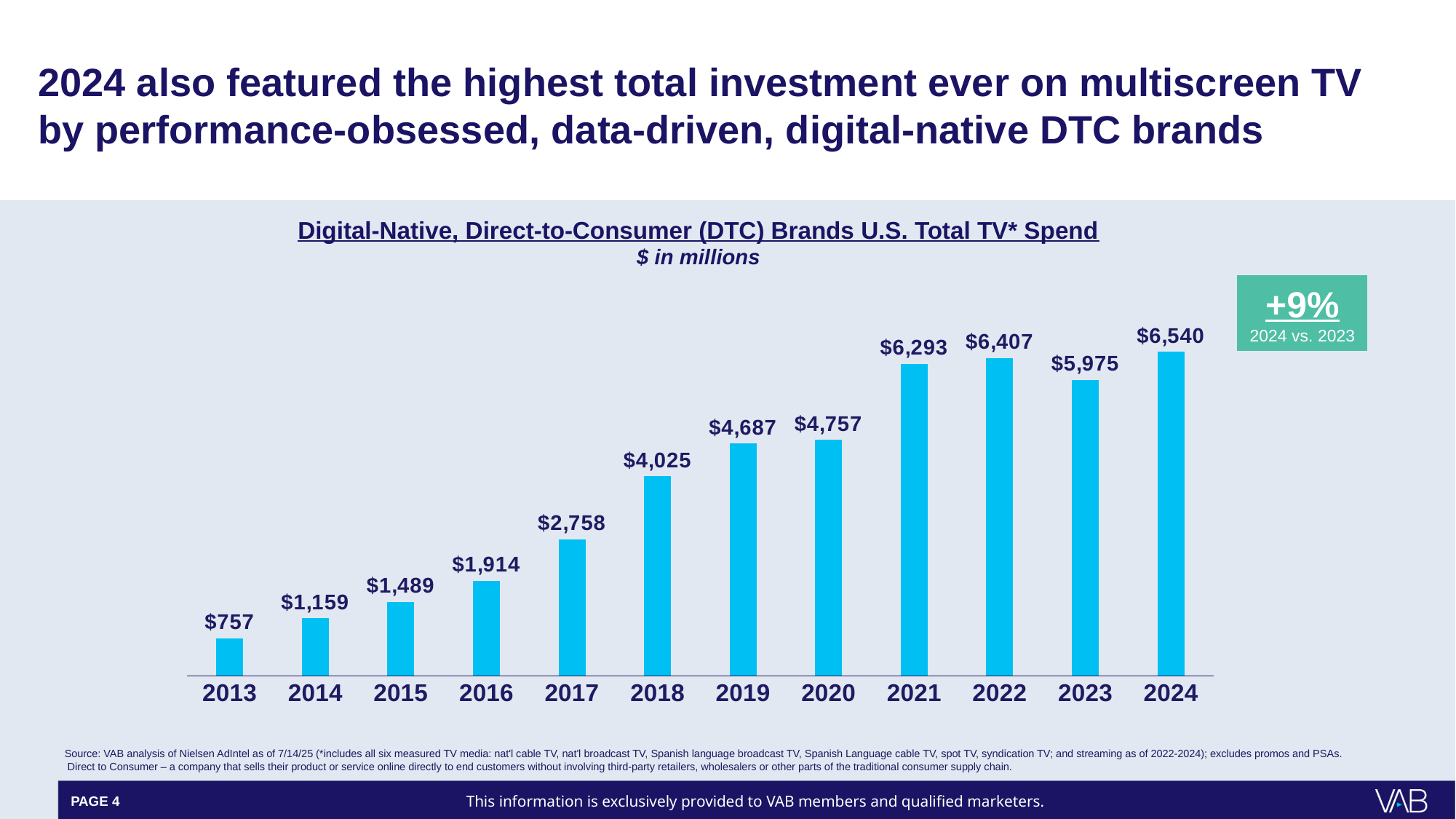
What is the difference in DTC brands' U.S. total TV spend between 2024 and 2023? $565 What was the DTC brands' U.S. total TV spend in 2023? $5,975 What kind of chart is shown on the slide? Bar chart What was the DTC brands' U.S. total TV spend in 2013? $757 Which year had the lowest DTC brands' U.S. total TV spend? 2013 What is the difference in DTC brands' U.S. total TV spend between 2017 and 2016? $844 Which year had the highest DTC brands' U.S. total TV spend? 2024 What percentage change from 2023 to 2024 is highlighted in the green box on the chart? +9% Did DTC brands' U.S. total TV spend generally rise or fall from 2013 to 2024? Rise Which year had a higher DTC brands' U.S. total TV spend, 2022 or 2023? 2022 What was the DTC brands' U.S. total TV spend in 2018? $4,025 How many years are shown on the chart? 12